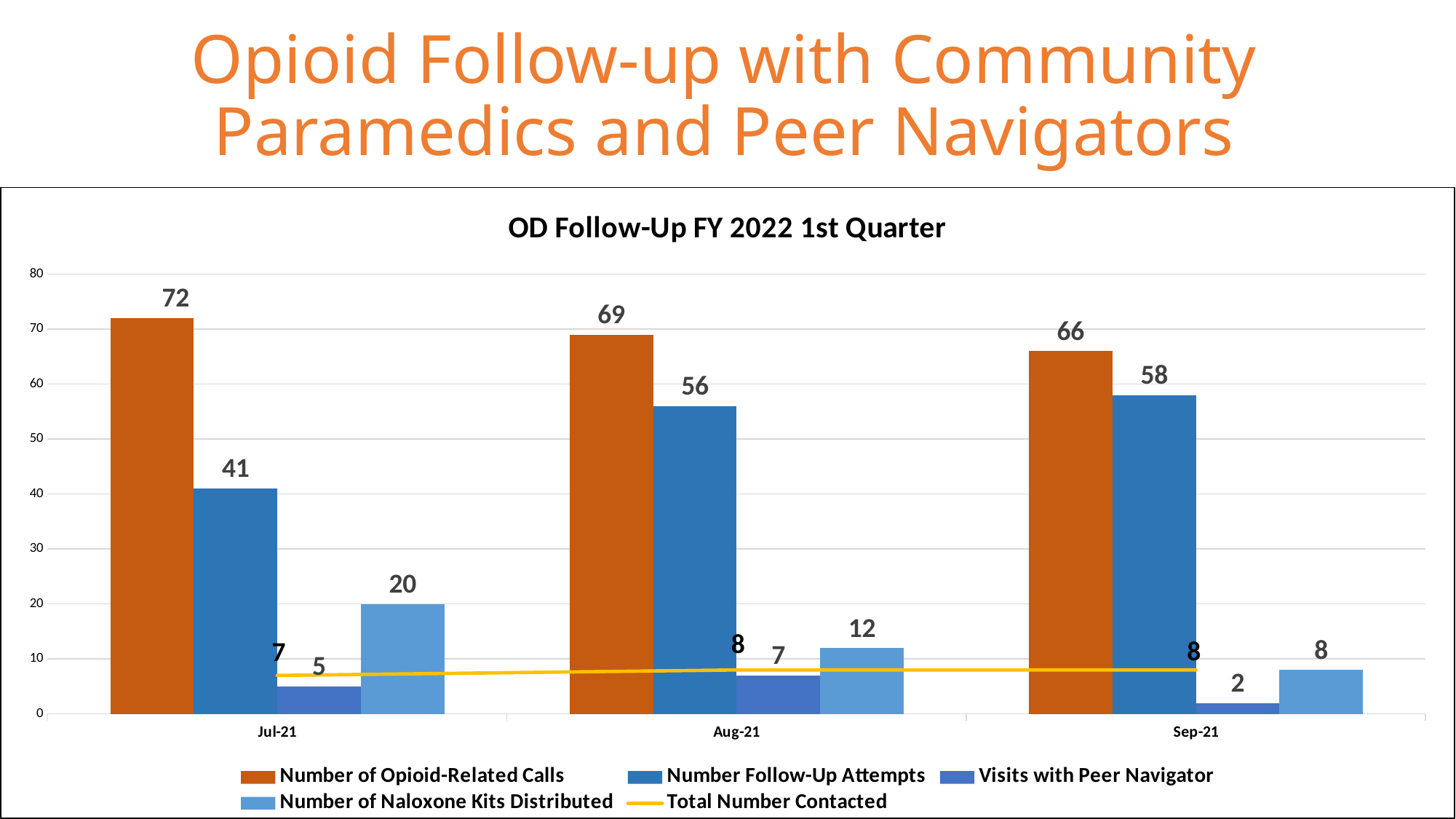
What is the difference between the Number of Opioid-Related Calls and the Number Follow-Up Attempts in Jul-21? 31 What is the title of the chart? OD Follow-Up FY 2022 1st Quarter How many series does the legend list? 5 How many Naloxone Kits were distributed in Sep-21? 8 What is the Visits with Peer Navigator value for Aug-21? 7 What is the Number of Opioid-Related Calls for Jul-21? 72 Do the Number of Opioid-Related Calls rise or fall from Jul-21 to Sep-21? fall Which month has the lowest Visits with Peer Navigator? Sep-21 Which month has the highest Number of Opioid-Related Calls? Jul-21 What is the Number Follow-Up Attempts value for Aug-21? 56 Which is larger in Sep-21: Number Follow-Up Attempts or Number of Naloxone Kits Distributed? Number Follow-Up Attempts How many months are shown on the x axis? 3